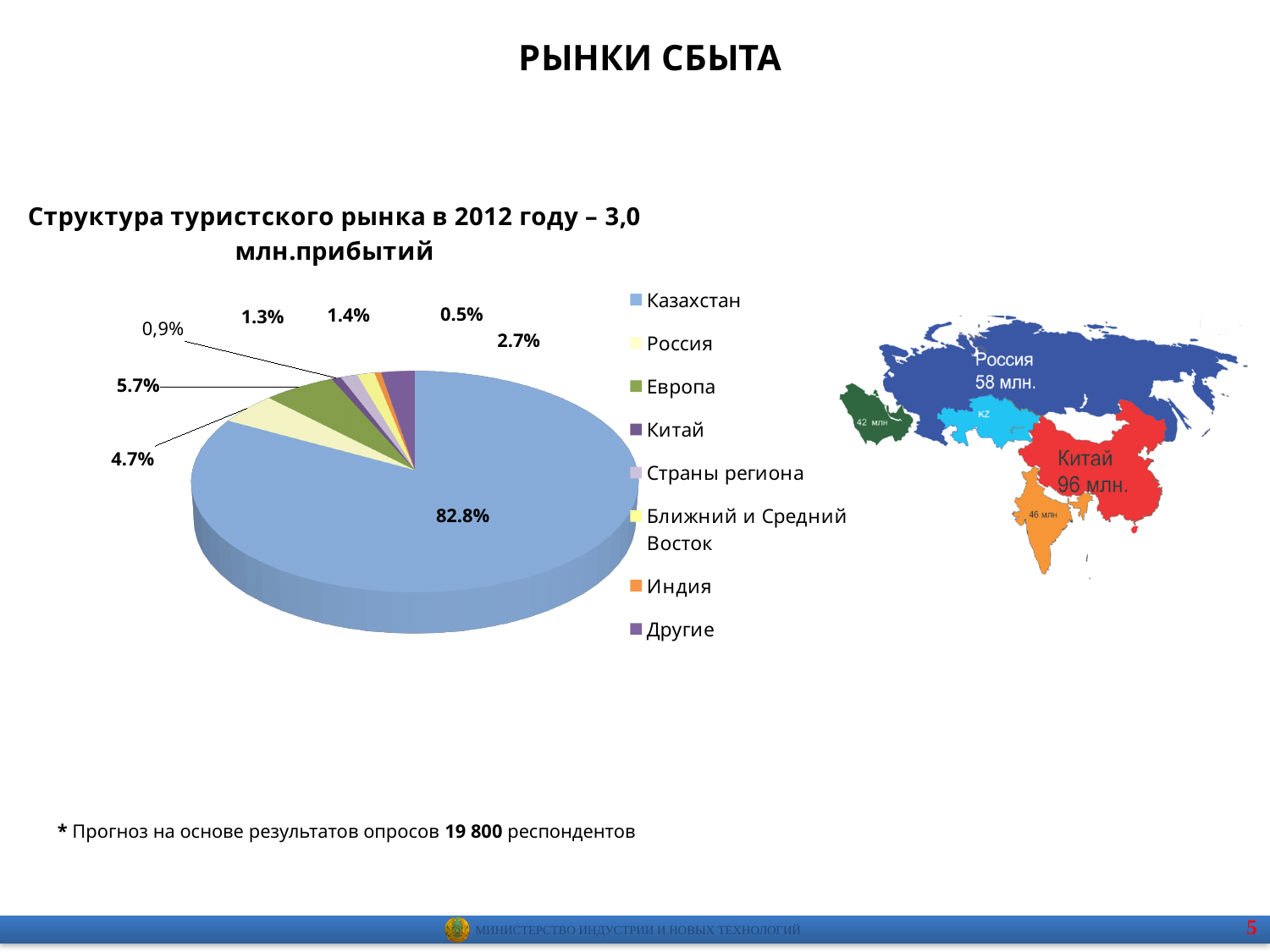
What is the value shown for Другие in the pie chart? 2.7% What is the value shown for Индия in the pie chart? 0.5% Which category has the smallest slice in the pie chart? Индия Which is larger in the pie chart, the share for Европа or the share for Россия? Европа What share of the pie chart does Казахстан hold? 82.8% What is the title of the chart? Структура туристского рынка в 2012 году – 3,0 млн.прибытий What is the difference between the share for Казахстан and the share for Европа? 77.1% What is the value shown for Европа in the pie chart? 5.7% What kind of chart is shown on the slide? Pie chart Which category has the largest slice in the pie chart? Казахстан What is the value shown for Россия in the pie chart? 4.7% How many categories does the pie chart's legend list? 8